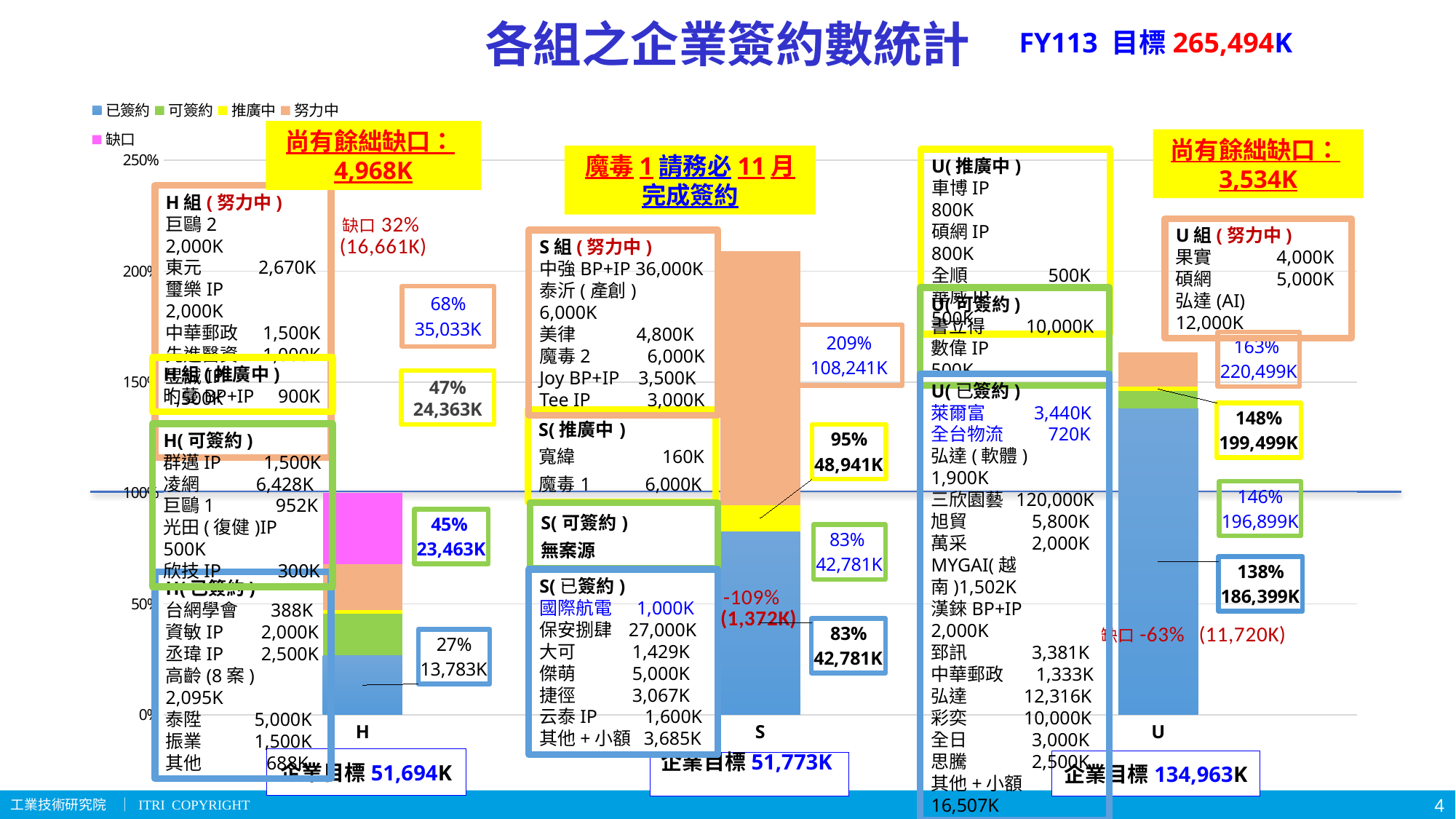
What percentage is labelled for the 努力中 level of group S? 209% What value is labelled for the 努力中 level of group U? 220,499K What percentage is labelled for the 已簽約 (signed) level of group S? 83% How many series does the chart legend list? 5 Which is larger, the 已簽約 value for group U or for group S? U Which group has the shortest stacked bar? H What value is labelled for the 已簽約 (signed) level of group U? 186,399K What is the title of the chart? 各組之企業簽約數統計 Which group has the tallest stacked bar? S What value is labelled for the 已簽約 (signed) level of group H? 13,783K What kind of chart is shown on the slide? stacked bar chart How many groups (categories) are shown on the x axis of the chart? 3